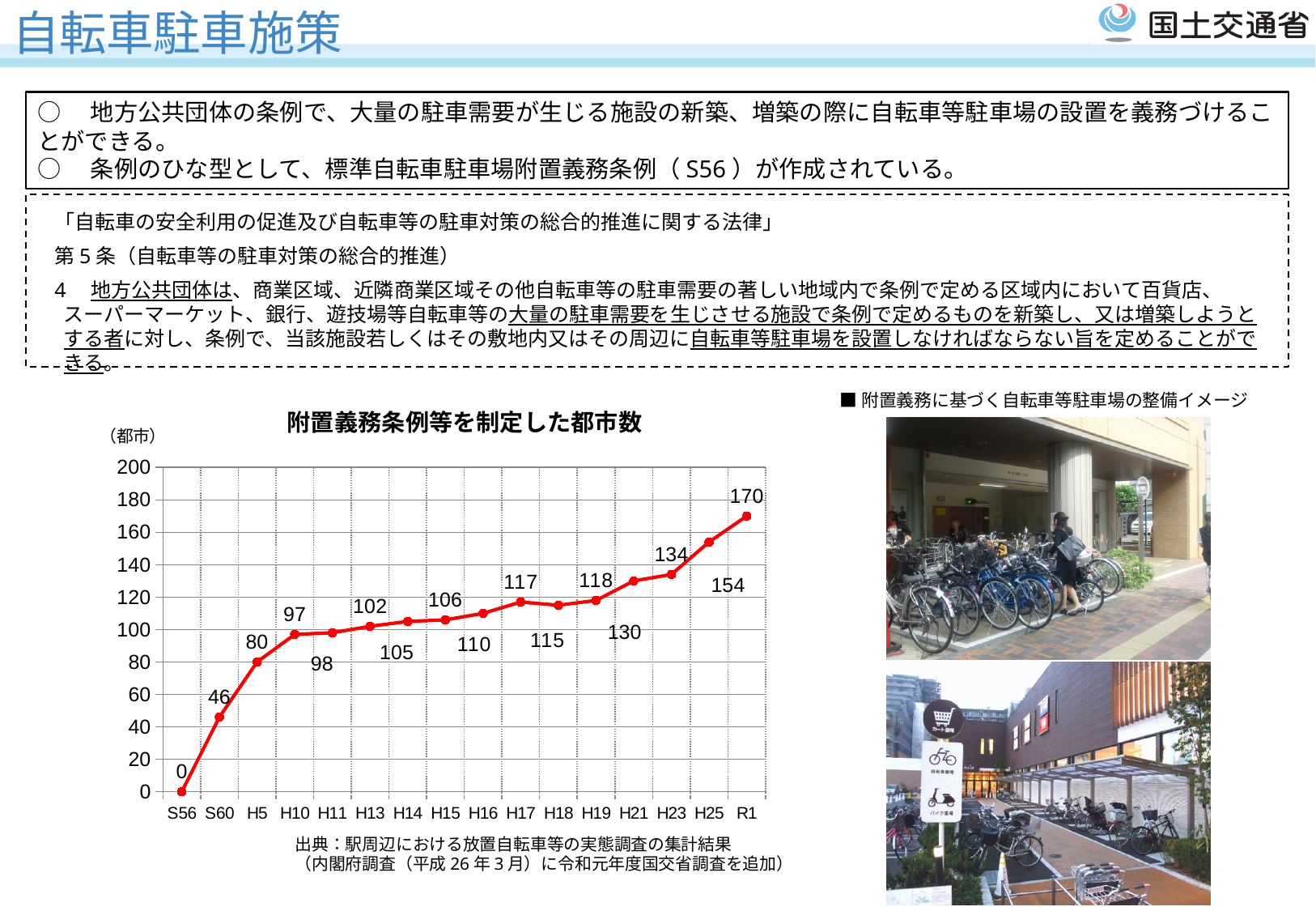
Which is larger in the chart 附置義務条例等を制定した都市数, the value for H17 or the value for H18? H17 What is the value for H10 in the chart 附置義務条例等を制定した都市数? 97 What is the value for H21 in the chart 附置義務条例等を制定した都市数? 130 What is the difference between the values for R1 and H25 in the chart 附置義務条例等を制定した都市数? 16 Which year has the lowest value in the chart 附置義務条例等を制定した都市数? S56 What is the value for R1 in the chart 附置義務条例等を制定した都市数? 170 What type of chart is used to show 附置義務条例等を制定した都市数? line chart Which year has the highest value in the chart 附置義務条例等を制定した都市数? R1 What is the value for S60 in the chart 附置義務条例等を制定した都市数? 46 How many data points are plotted in the chart 附置義務条例等を制定した都市数? 16 What unit is shown on the y axis of the chart 附置義務条例等を制定した都市数? 都市 Overall, do the values in the chart 附置義務条例等を制定した都市数 rise or fall from S56 to R1? rise